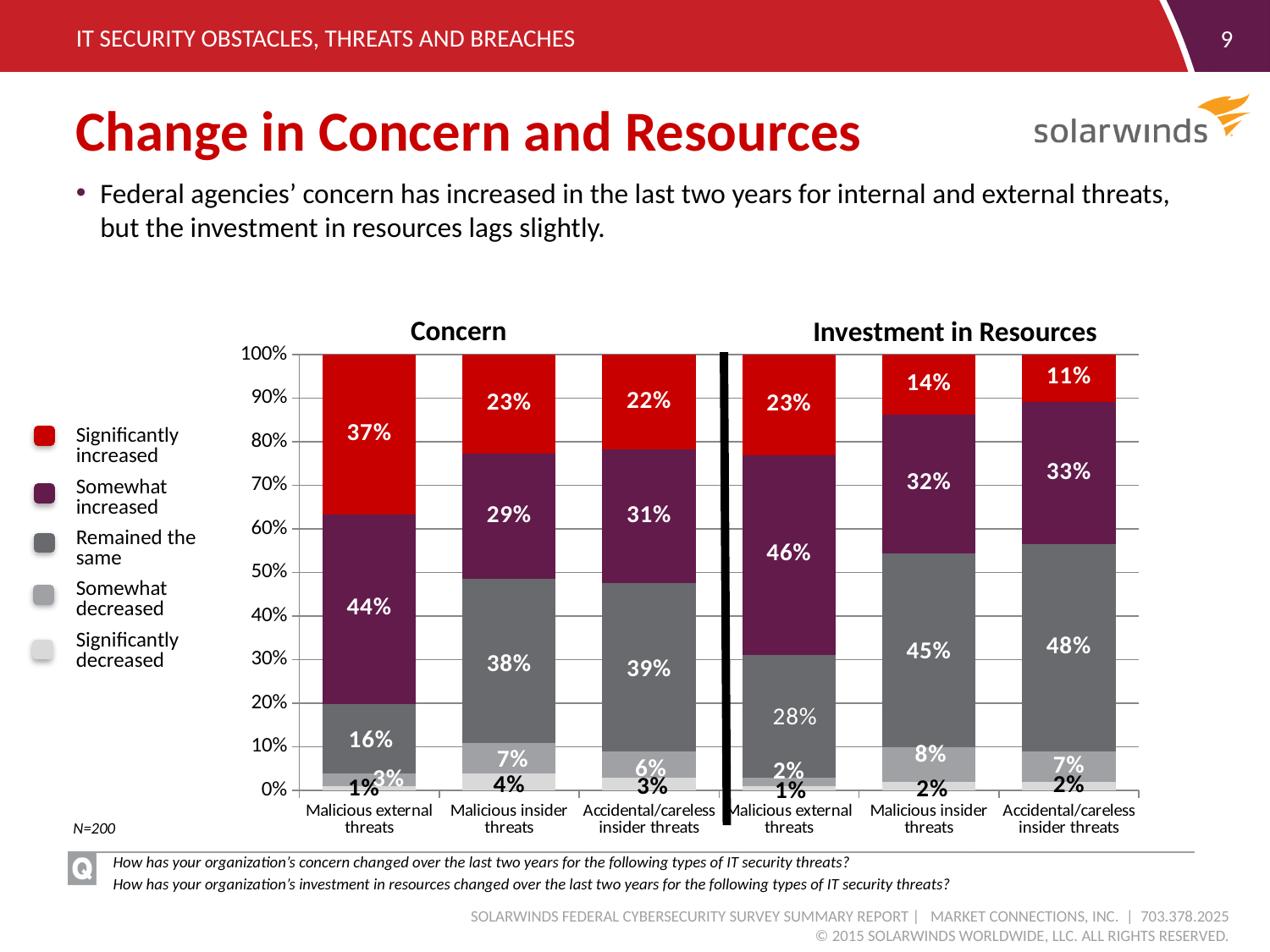
In the Investment in Resources panel, what is the 'Somewhat increased' value for malicious external threats? 46% In the Investment in Resources panel, what is the 'Somewhat decreased' value for malicious insider threats? 8% In the Investment in Resources panel, which threat type has the lowest 'Significantly increased' percentage? Accidental/careless insider threats In the Concern panel, which threat type has the highest 'Significantly increased' percentage? Malicious external threats In the Investment in Resources panel, what is the 'Remained the same' value for accidental/careless insider threats? 48% What kind of chart is shown on the slide? Stacked bar chart What is the difference between the 'Significantly increased' value for malicious external threats in the Concern panel (37%) and in the Investment in Resources panel (23%)? 14% In the Concern panel, what percentage of respondents said concern about malicious external threats significantly increased? 37% How many series does the legend list? 5 How many threat categories are shown in the Investment in Resources panel? 3 In the Concern panel, is the 'Remained the same' value larger for malicious insider threats or for accidental/careless insider threats? Accidental/careless insider threats Which colour represents 'Significantly increased' in the legend? Red